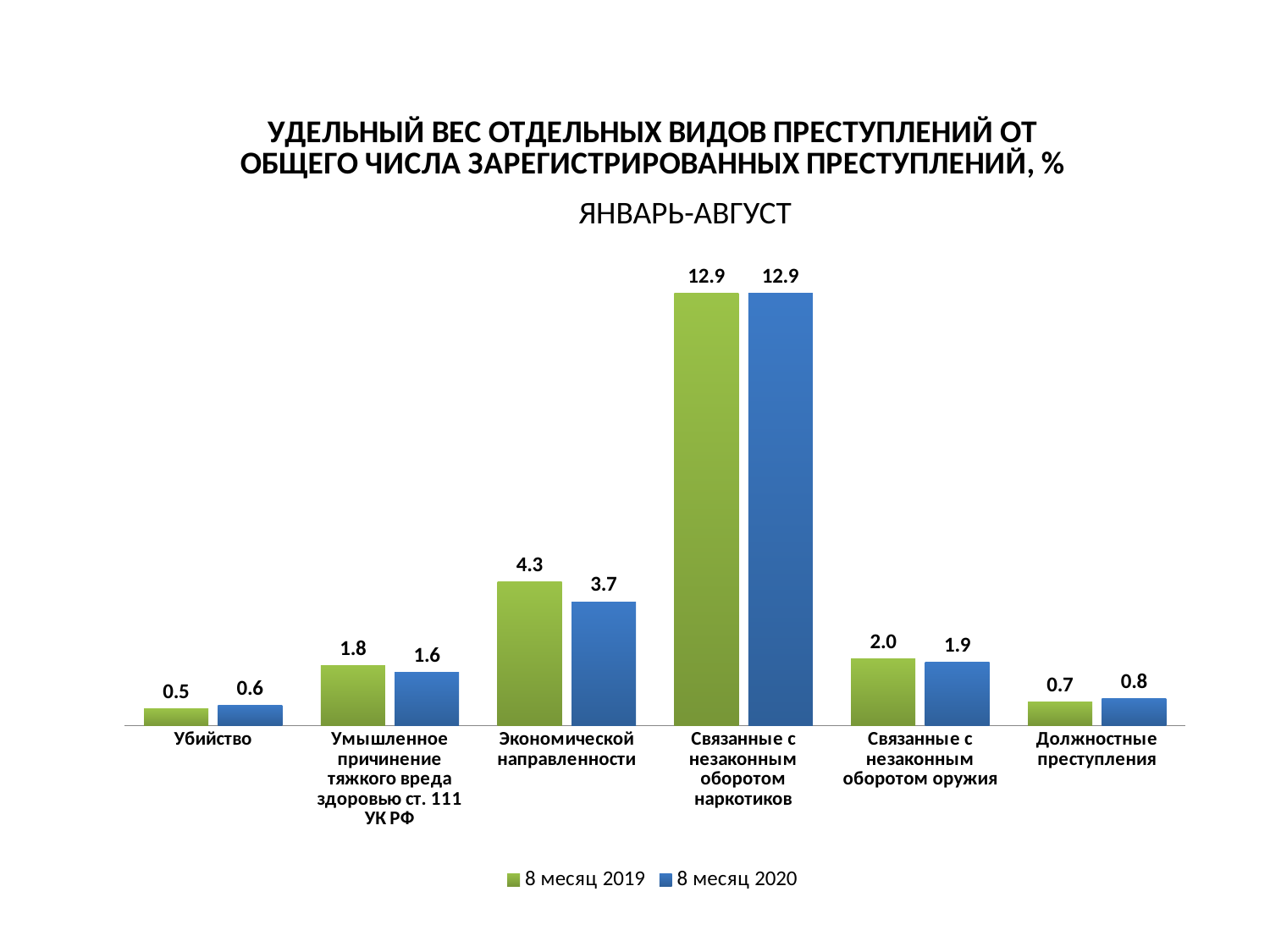
Which is larger for Умышленное причинение тяжкого вреда здоровью ст. 111 УК РФ: the 8 месяц 2019 value or the 8 месяц 2020 value? 8 месяц 2019 Which colour represents the 8 месяц 2020 series? Blue What is the value for Должностные преступления in the 8 месяц 2020 series? 0.8 What is the value for Связанные с незаконным оборотом оружия in the 8 месяц 2019 series? 2.0 What kind of chart is shown on the slide? Bar chart How many series does the legend list? 2 Which category has the highest value in the 8 месяц 2019 series? Связанные с незаконным оборотом наркотиков What is the value for Экономической направленности in the 8 месяц 2020 series? 3.7 How many categories are shown on the x axis? 6 Which category has the lowest value in the 8 месяц 2020 series? Убийство What is the value for Убийство in the 8 месяц 2019 series? 0.5 What is the difference between the 8 месяц 2019 and 8 месяц 2020 values for Экономической направленности? 0.6